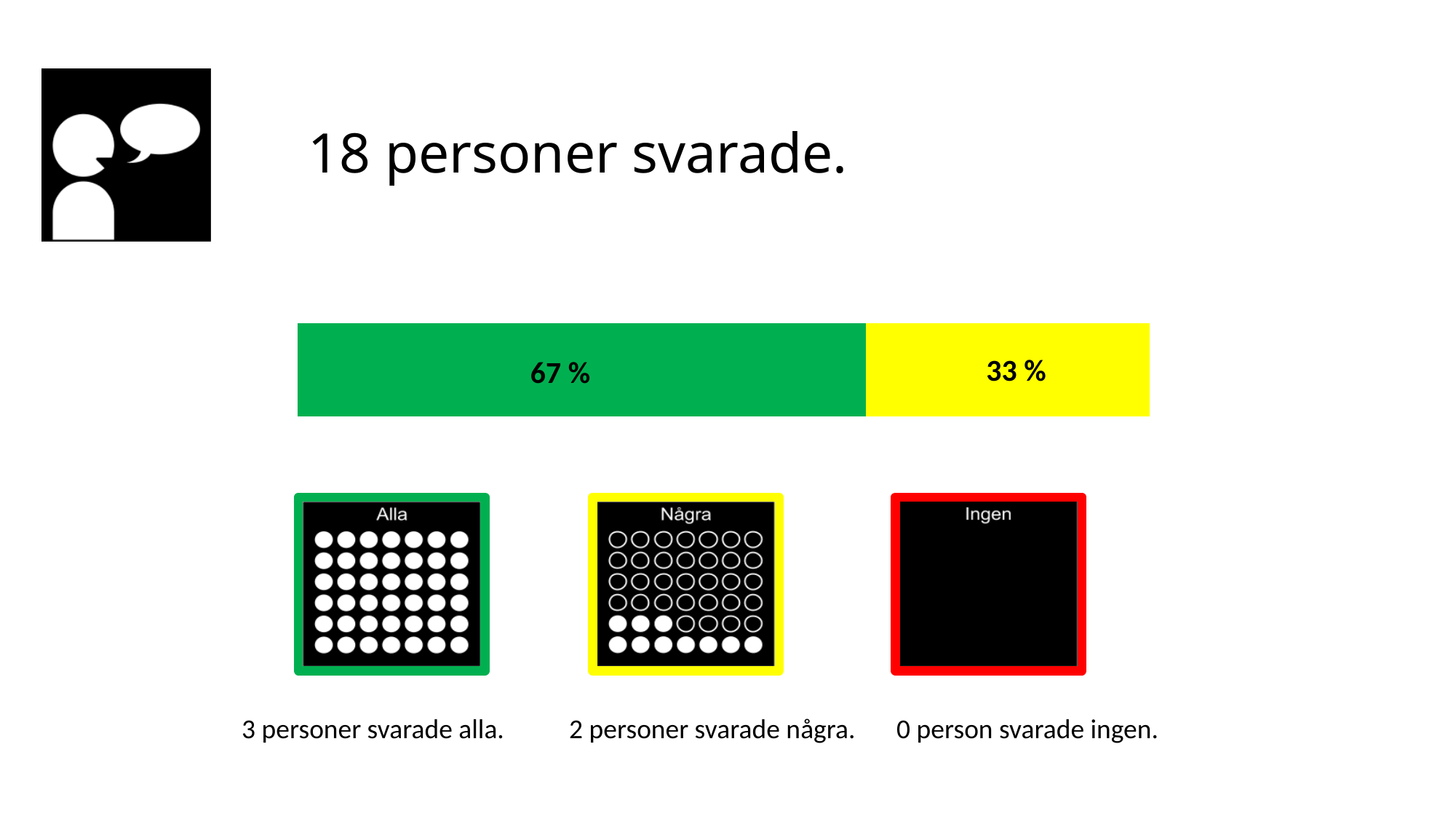
What kind of chart is shown on the slide? stacked bar chart Which segment of the bar has the highest value? green (67 %) What is the title text above the chart? 18 personer svarade. According to the colour key below the bar, which category does the green colour represent? Alla How many segments does the stacked bar contain? 2 Which segment of the bar is larger, the green one or the yellow one? green What is the total of the two segments in the stacked bar? 100 % What value is printed on the yellow segment of the bar? 33 % What value is printed on the green segment of the bar? 67 % Which segment of the bar has the lowest value? yellow (33 %) What is the difference between the green segment's value and the yellow segment's value? 34 %